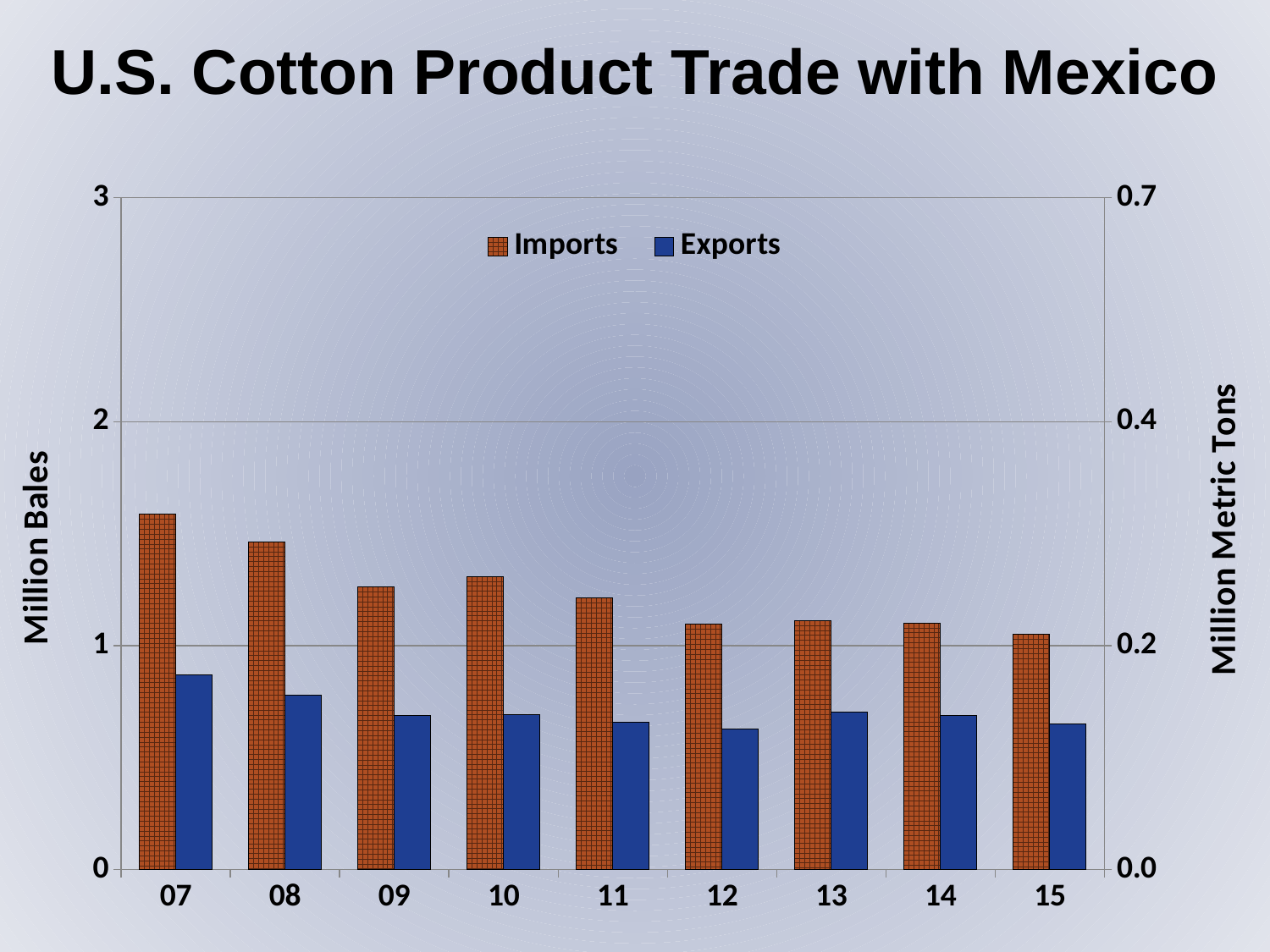
How many series does the legend list? 2 Is the Imports value for 08 greater or less than 1 million bales? greater Do Imports generally rise or fall from 07 to 15? fall What is the label on the left vertical axis? Million Bales Which year has the highest Imports value? 07 Is the Imports value for 07 greater or less than 2 million bales? less Which year has the larger Imports value, 07 or 08? 07 Is the Exports value for 07 greater or less than 1 million bales? less Which year has the highest Exports value? 07 How many years are shown on the x axis? 9 Which is larger in 07, Imports or Exports? Imports What kind of chart is shown on the slide? bar chart